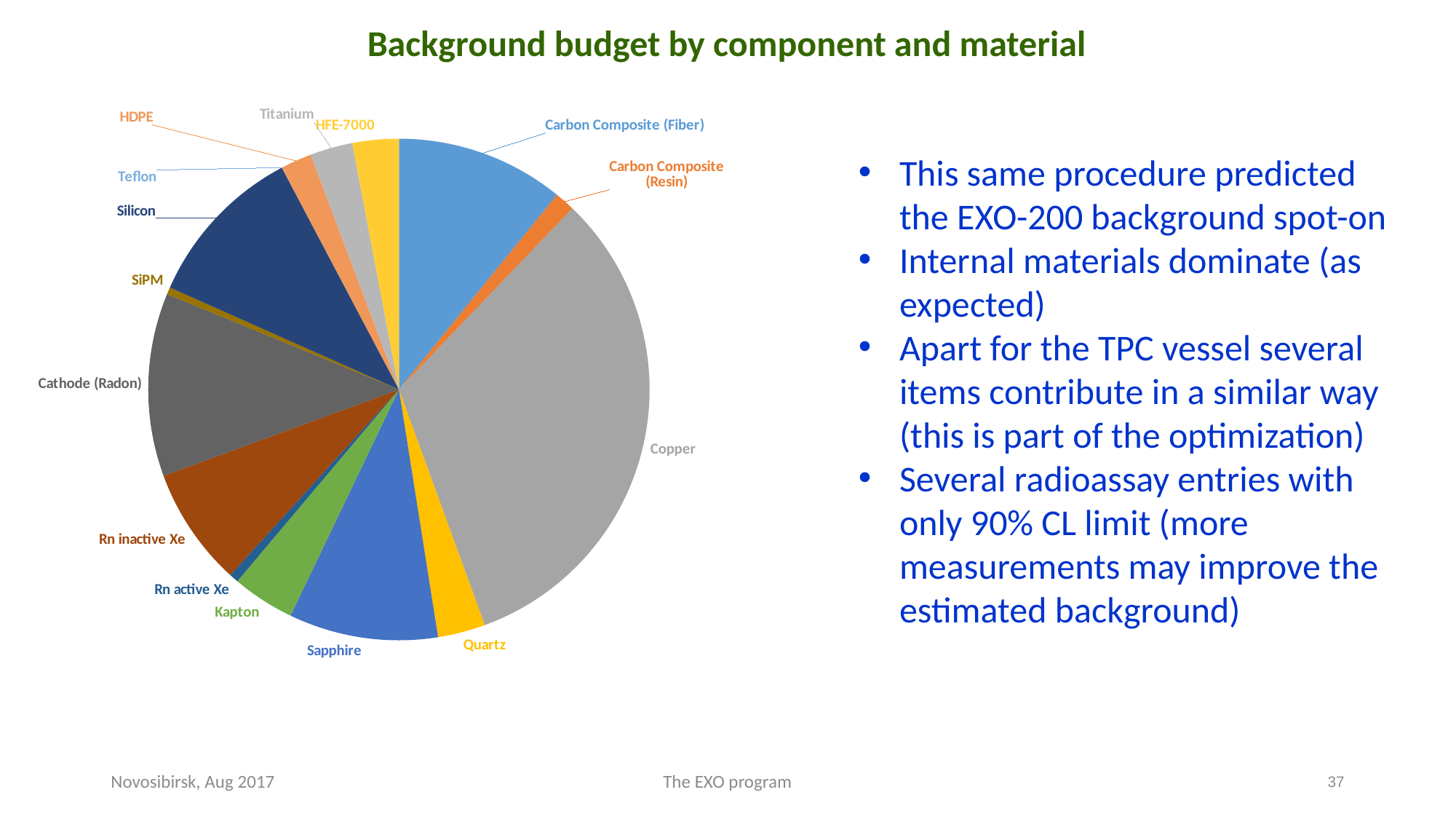
Which slice is larger, Silicon or Kapton? Silicon Which category has the largest slice of the pie? Copper What is the title of the chart? Background budget by component and material What colour is the Copper slice of the pie? grey Which slice is larger, Rn inactive Xe or Rn active Xe? Rn inactive Xe Which slice is larger, Carbon Composite (Fiber) or Carbon Composite (Resin)? Carbon Composite (Fiber) What kind of chart is shown on the slide? pie chart